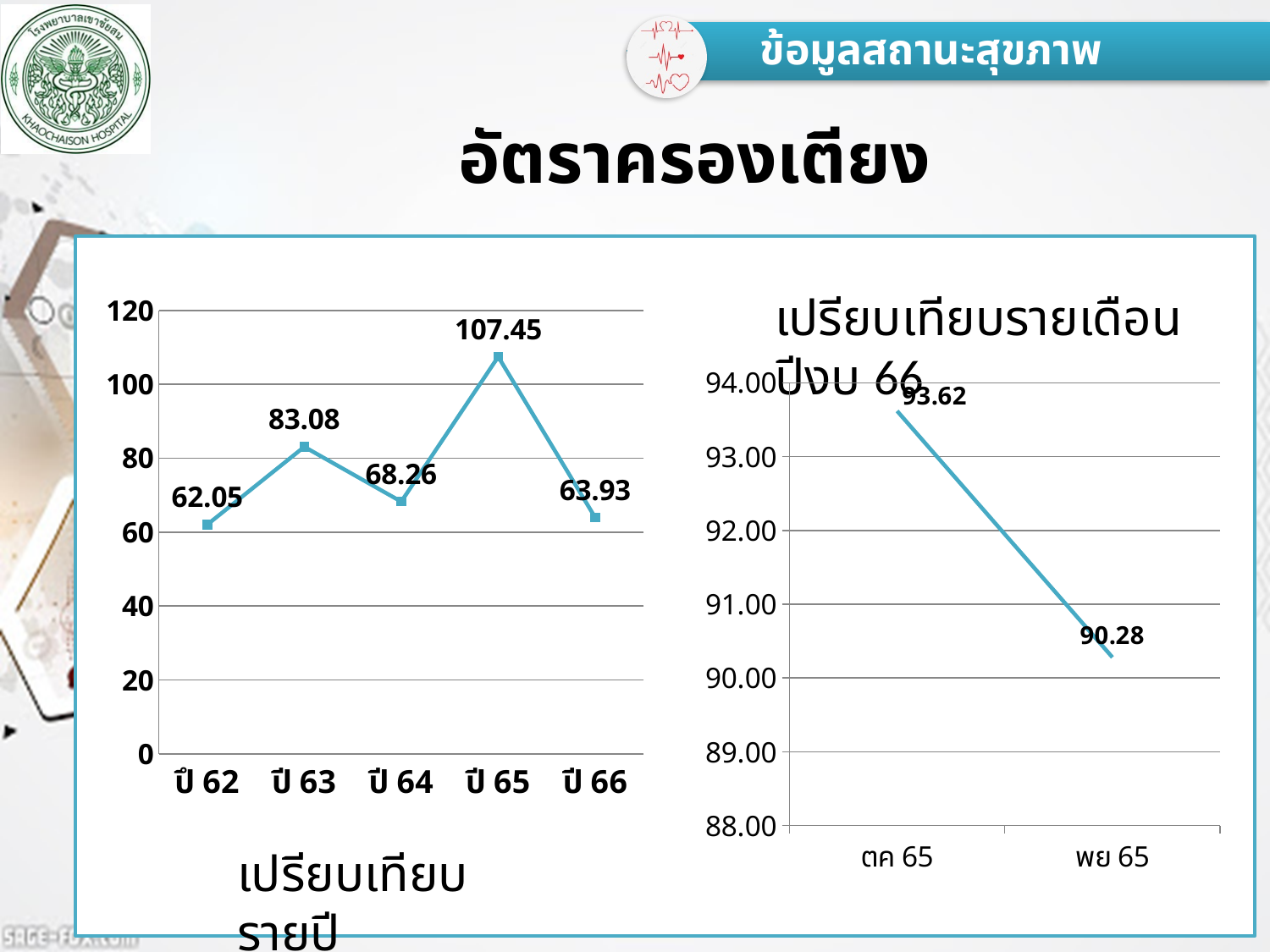
In the left chart (yearly comparison), what is the value for ปี 62? 62.05 In the left chart (yearly comparison), which is larger, the value for ปี 63 or ปี 64? ปี 63 In the left chart (yearly comparison), which year has the lowest value? ปี 62 In the left chart (yearly comparison), what is the difference between the values for ปี 65 and ปี 66? 43.52 In the right chart (monthly comparison FY 66), what is the value for พย 65? 90.28 In the right chart (monthly comparison FY 66), what is the difference between the values for ตค 65 and พย 65? 3.34 In the right chart (monthly comparison FY 66), what is the value for ตค 65? 93.62 In the right chart (monthly comparison FY 66), does the value rise or fall from ตค 65 to พย 65? Fall In the left chart (yearly comparison), what is the value for ปี 65? 107.45 In the left chart (yearly comparison), how many years are plotted? 5 In the left chart (yearly comparison), which year has the highest value? ปี 65 What type of chart is the left chart (yearly comparison)? Line chart